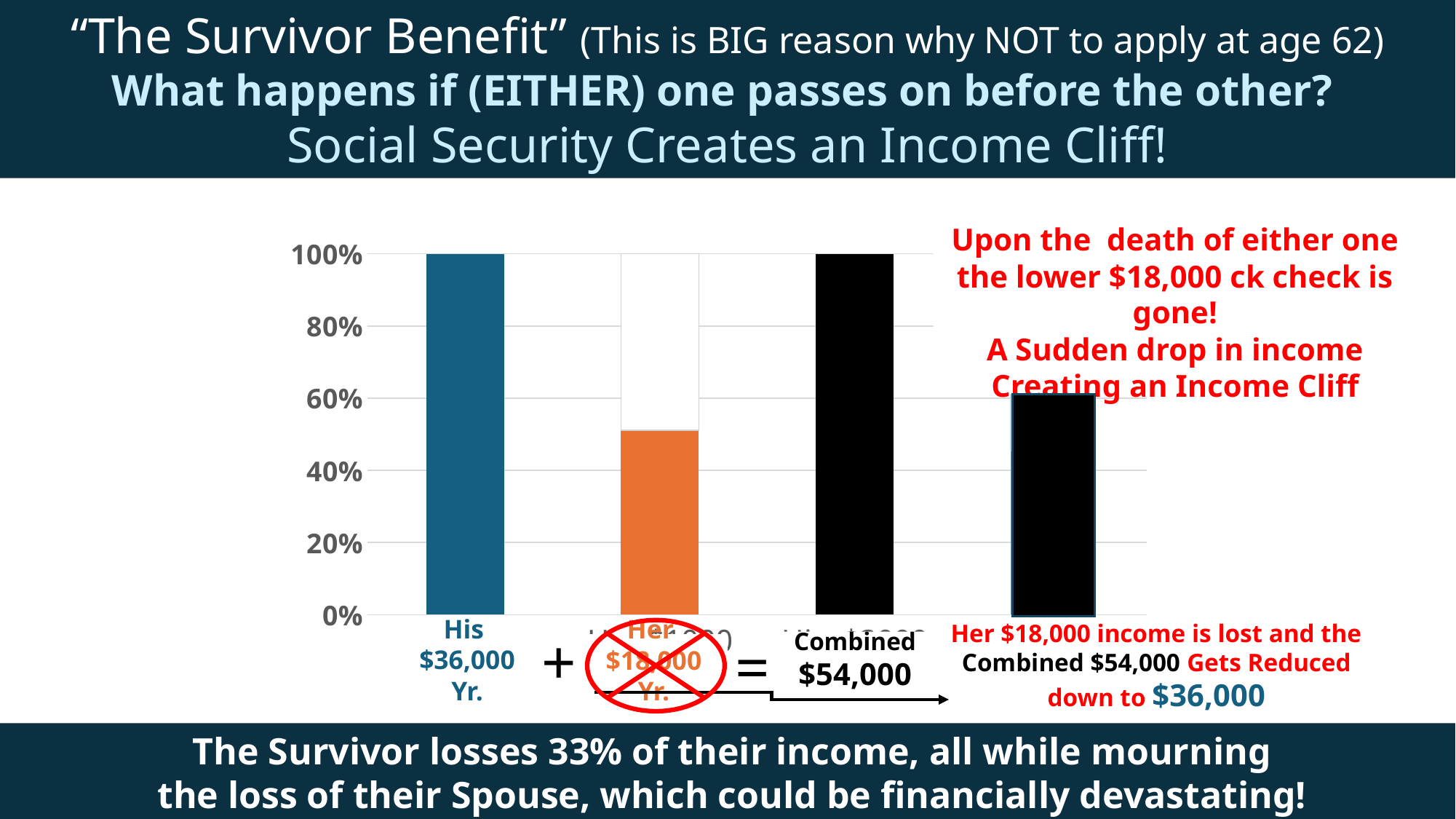
What is the difference between the 'His' amount ($36,000) and the 'Her' amount ($18,000) shown under the bars? $18,000 Is the value of the rightmost bar greater or less than 80%? less What yearly dollar amount is labeled under the 'Her' bar? $18,000 What percentage does the 'Combined' bar reach on the y axis? 100% Is the value of the 'Her' bar greater or less than 40%? greater What kind of chart is shown on the slide? bar chart Is the value of the 'Her' bar greater or less than 60%? less How many bars are plotted in the chart? 4 Which bar is taller, 'His' or 'Her'? His What percentage does the 'His' bar reach on the y axis? 100% What yearly dollar amount is labeled under the 'His' bar? $36,000 What colour is the 'Her' bar? orange